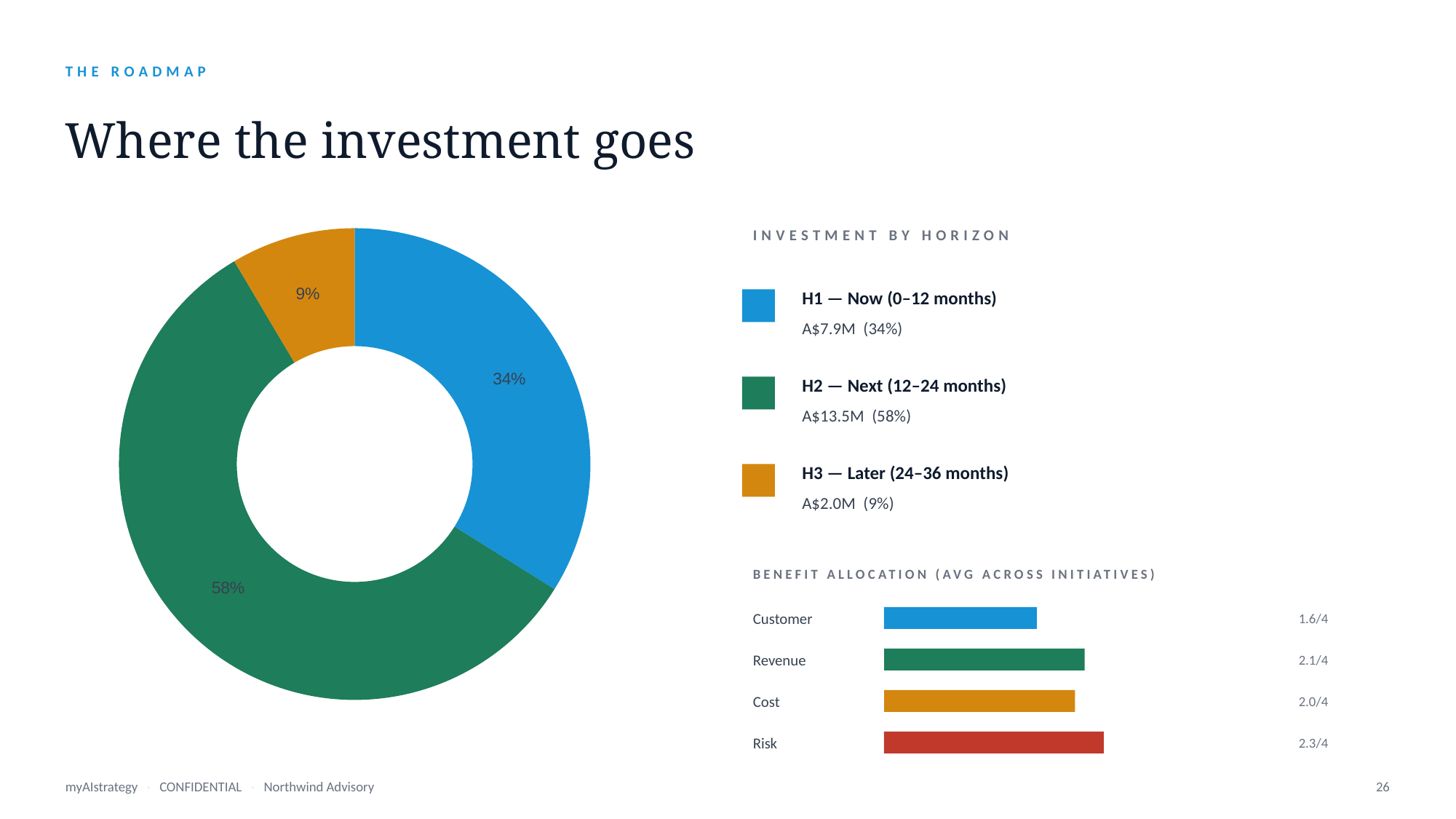
In the Investment by Horizon donut chart, what share of investment goes to H2 — Next (12–24 months)? 58% In the Benefit Allocation bar chart, which category has the highest value? Risk In the Benefit Allocation bar chart, what is the value for Risk? 2.3/4 In the Investment by Horizon donut chart, what is the difference in percentage points between the H2 and H1 shares? 24 percentage points In the Investment by Horizon donut chart, which horizon receives the smallest share of investment? H3 — Later (24–36 months) What kind of chart is the Benefit Allocation chart? Bar chart What kind of chart is the Investment by Horizon chart? Donut chart In the Investment by Horizon donut chart, what is the investment amount for H1 — Now (0–12 months)? A$7.9M In the Investment by Horizon donut chart, how many horizons are shown? 3 In the Benefit Allocation bar chart, which is larger, the value for Revenue or the value for Cost? Revenue In the Investment by Horizon donut chart, which horizon receives the largest share of investment? H2 — Next (12–24 months) In the Benefit Allocation bar chart, which category has the lowest value? Customer